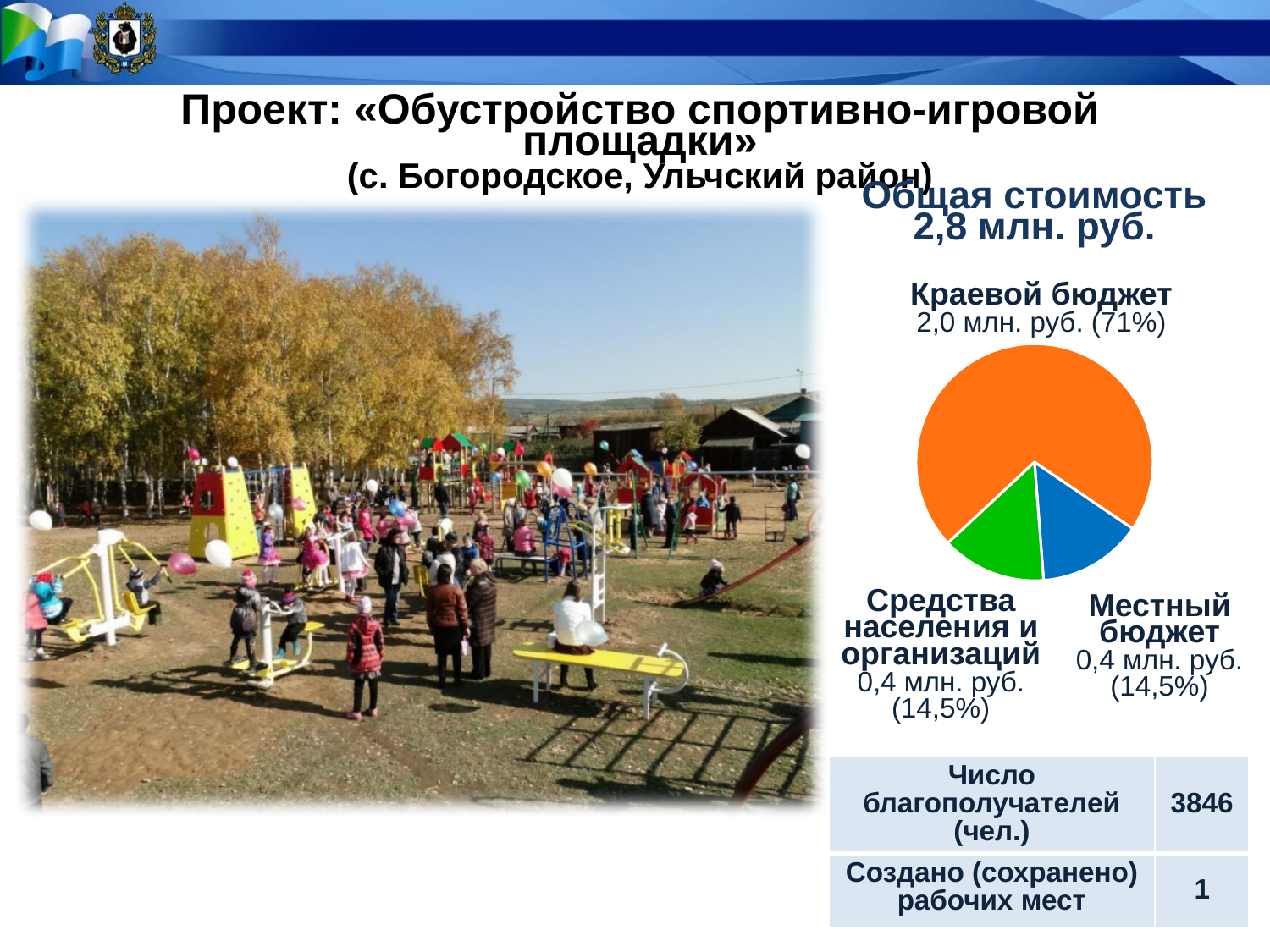
What kind of chart is shown on the slide? pie chart Which is larger: Краевой бюджет or Средства населения и организаций? Краевой бюджет How many slices does the pie chart have? 3 What is the value for Краевой бюджет in the pie chart? 2,0 млн. руб. Which funding source has the largest slice of the pie chart? Краевой бюджет What colour is the slice for Краевой бюджет in the pie chart? orange What share of the pie does Краевой бюджет represent? 71% What is the value for Средства населения и организаций in the pie chart? 0,4 млн. руб. What is the total cost (Общая стоимость) shown above the pie chart? 2,8 млн. руб. What share of the pie does Местный бюджет represent? 14,5% What is the value for Местный бюджет in the pie chart? 0,4 млн. руб. What is the difference between the values for Краевой бюджет and Местный бюджет? 1,6 млн. руб.